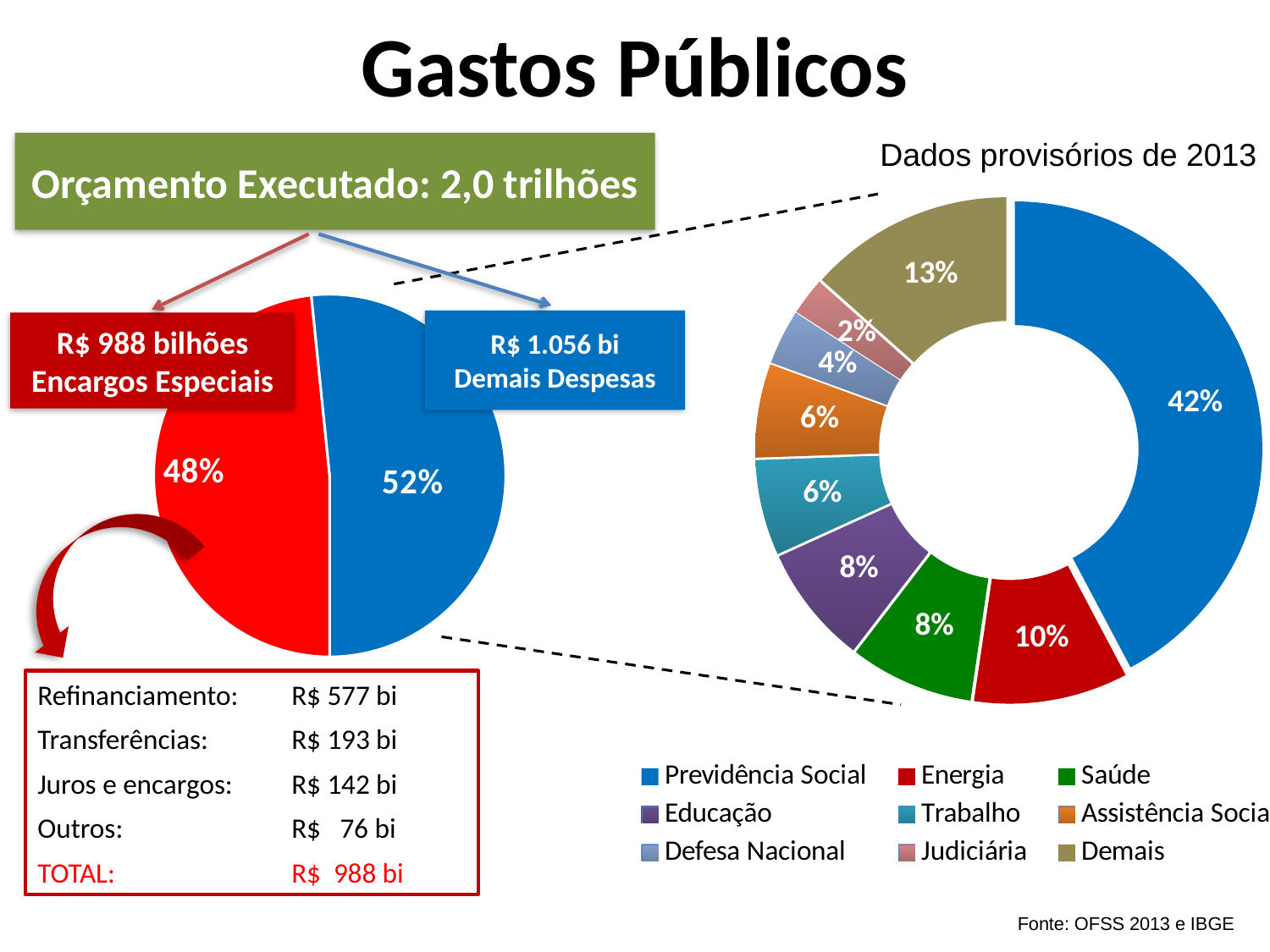
In the doughnut chart on the right, what percentage is shown for Defesa Nacional? 4% In the doughnut chart on the right, what is the difference in percentage points between Previdência Social and Demais? 29 percentage points In the left pie chart, what share is shown for Encargos Especiais? 48% In the doughnut chart on the right, which category has the largest share? Previdência Social In the left pie chart, what share is shown for Demais Despesas? 52% In the doughnut chart on the right, what percentage is shown for Energia? 10% In the left pie chart, which slice is larger, Encargos Especiais or Demais Despesas? Demais Despesas In the doughnut chart on the right, what percentage is shown for Demais? 13% In the doughnut chart on the right, what percentage is shown for Previdência Social? 42% What kind of chart is the chart on the left of the slide? Pie chart How many categories does the legend of the doughnut chart on the right list? 9 In the doughnut chart on the right, which category has the smallest share? Judiciária